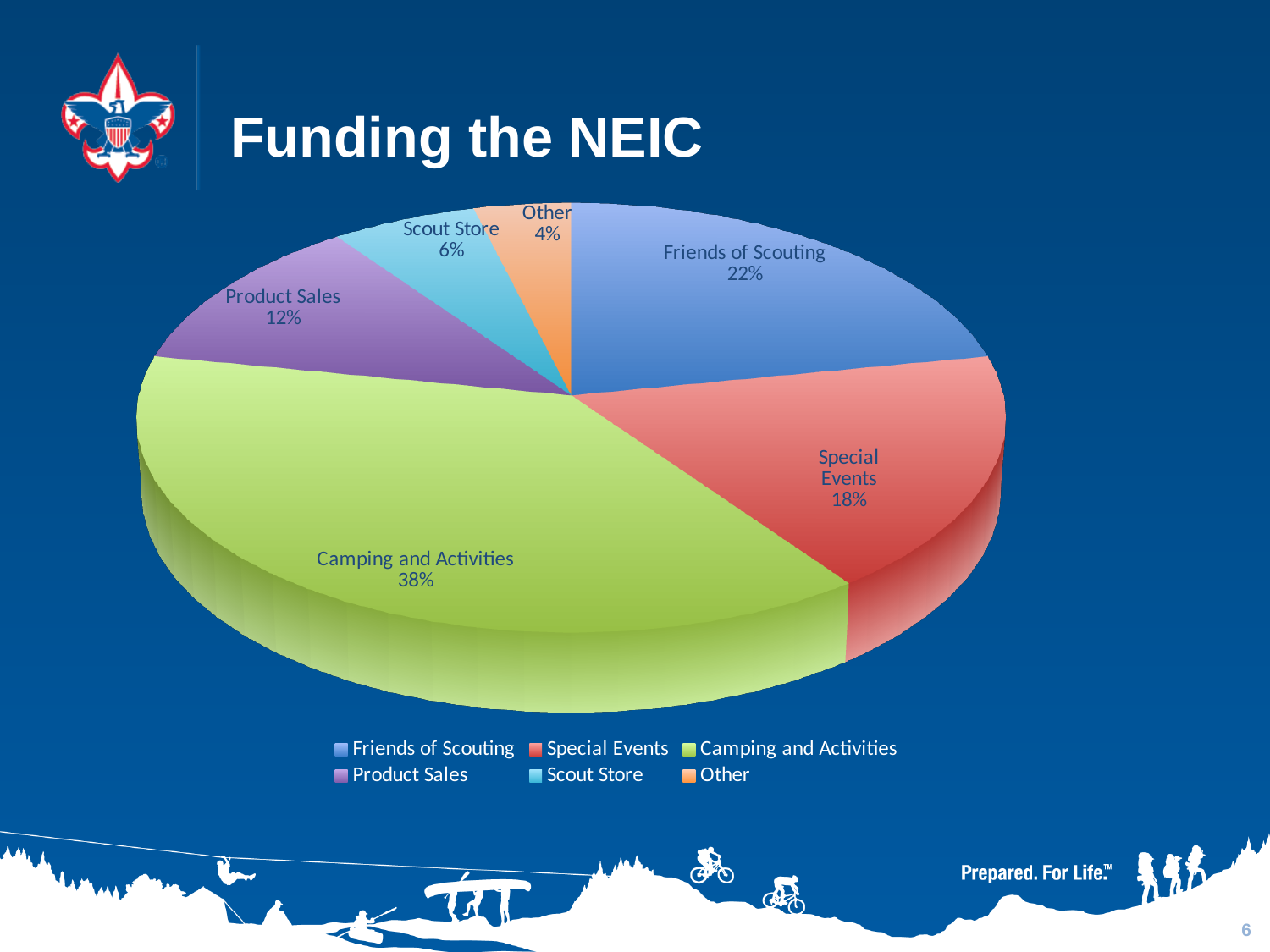
What share of funding comes from Camping and Activities? 38% What share of funding comes from Friends of Scouting? 22% How many slices does the pie chart have? 6 Which funding source has the largest share of the pie? Camping and Activities What share of funding comes from Special Events? 18% Which funding source has the smallest share of the pie? Other Which is larger, Special Events or Product Sales? Special Events What share of funding comes from the Scout Store? 6% What is the title of the slide containing the chart? Funding the NEIC How many percentage points larger is Camping and Activities than Friends of Scouting? 16 What kind of chart is shown on the slide? Pie chart What share of funding comes from Product Sales? 12%